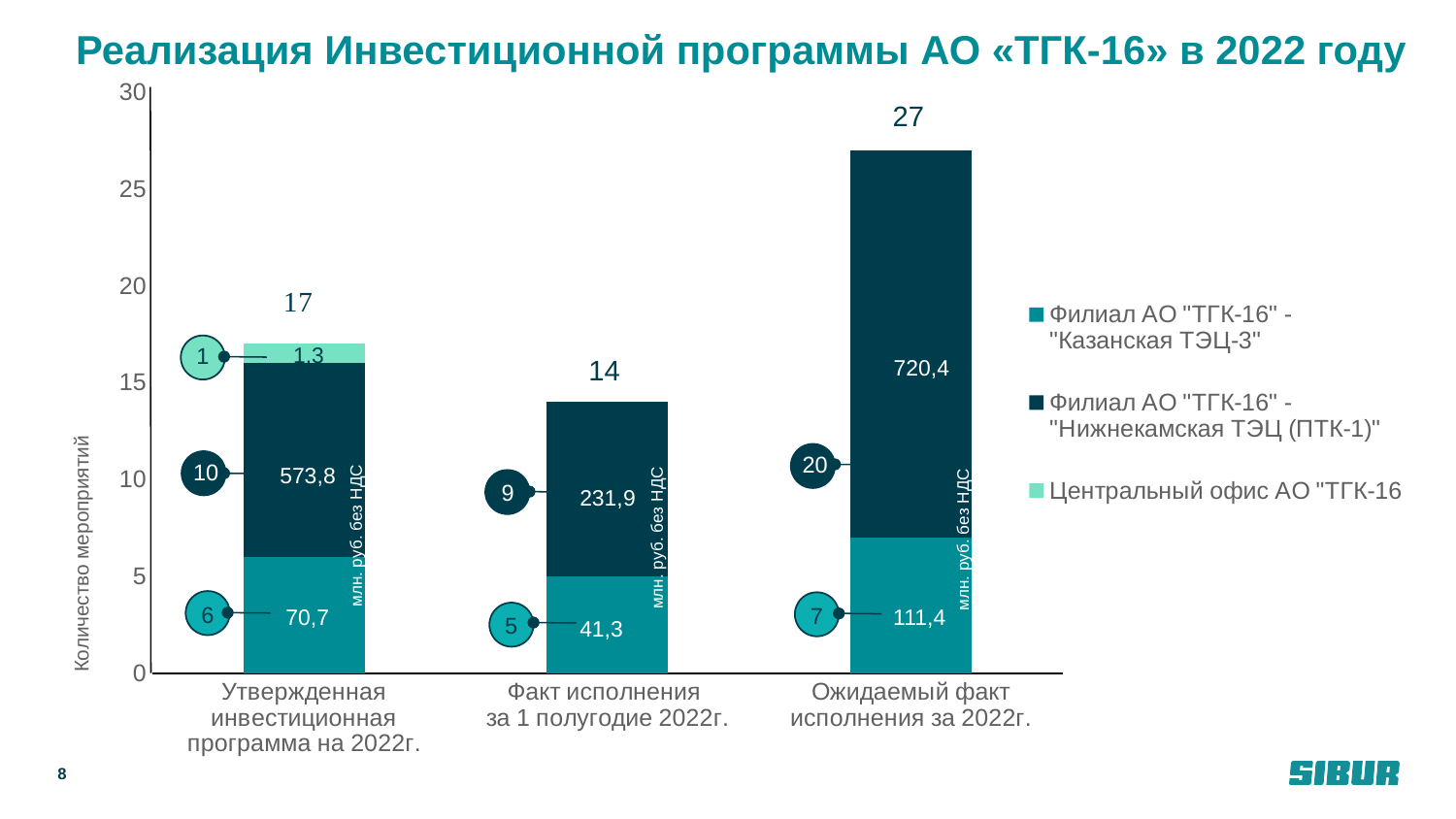
What is the amount in млн. руб. без НДС for Филиал АО "ТГК-16" - "Нижнекамская ТЭЦ (ПТК-1)" in the bar "Ожидаемый факт исполнения за 2022г."? 720,4 What is the difference between the total number of events for "Ожидаемый факт исполнения за 2022г." and "Утвержденная инвестиционная программа на 2022г."? 10 What is the total number of events (top label) for the bar "Факт исполнения за 1 полугодие 2022г."? 14 Which is larger: the number of events for Нижнекамская ТЭЦ (ПТК-1) in "Факт исполнения за 1 полугодие 2022г." or in "Ожидаемый факт исполнения за 2022г."? Ожидаемый факт исполнения за 2022г. How many series does the legend list? 3 What is the amount in млн. руб. без НДС for Филиал АО "ТГК-16" - "Казанская ТЭЦ-3" in the bar "Утвержденная инвестиционная программа на 2022г."? 70,7 What is the total number of events (top label) for the bar "Ожидаемый факт исполнения за 2022г."? 27 Which category has the lowest total number of events? Факт исполнения за 1 полугодие 2022г. Which series is shown in the lightest green colour in the legend? Центральный офис АО "ТГК-16 How many categories are shown on the x axis? 3 Which category has the highest total number of events? Ожидаемый факт исполнения за 2022г. What type of chart is shown on the slide? stacked bar chart